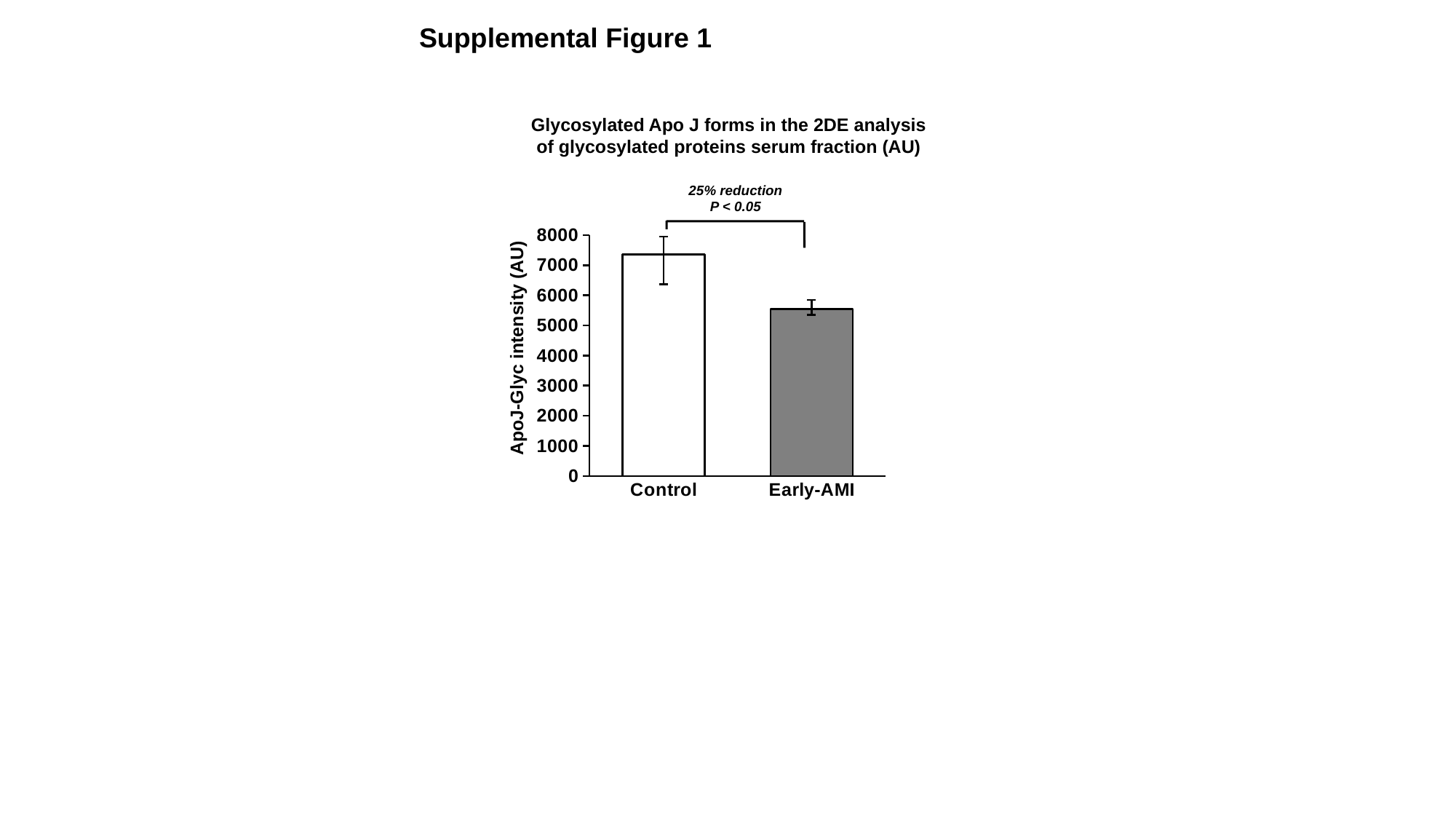
What is the maximum value shown on the y axis? 8000 What is the label of the y axis? ApoJ-Glyc intensity (AU) What kind of chart is shown on the slide? bar chart How many categories are plotted on the x axis? 2 Is the value for Control greater or less than 7000? greater What percentage reduction is annotated between the Control and Early-AMI bars? 25% reduction Is the value for Control greater or less than 8000? less Is the value for Early-AMI greater or less than 6000? less Which category has the lowest ApoJ-Glyc intensity? Early-AMI Which category has the highest ApoJ-Glyc intensity? Control Which is larger, the value for Control or the value for Early-AMI? Control